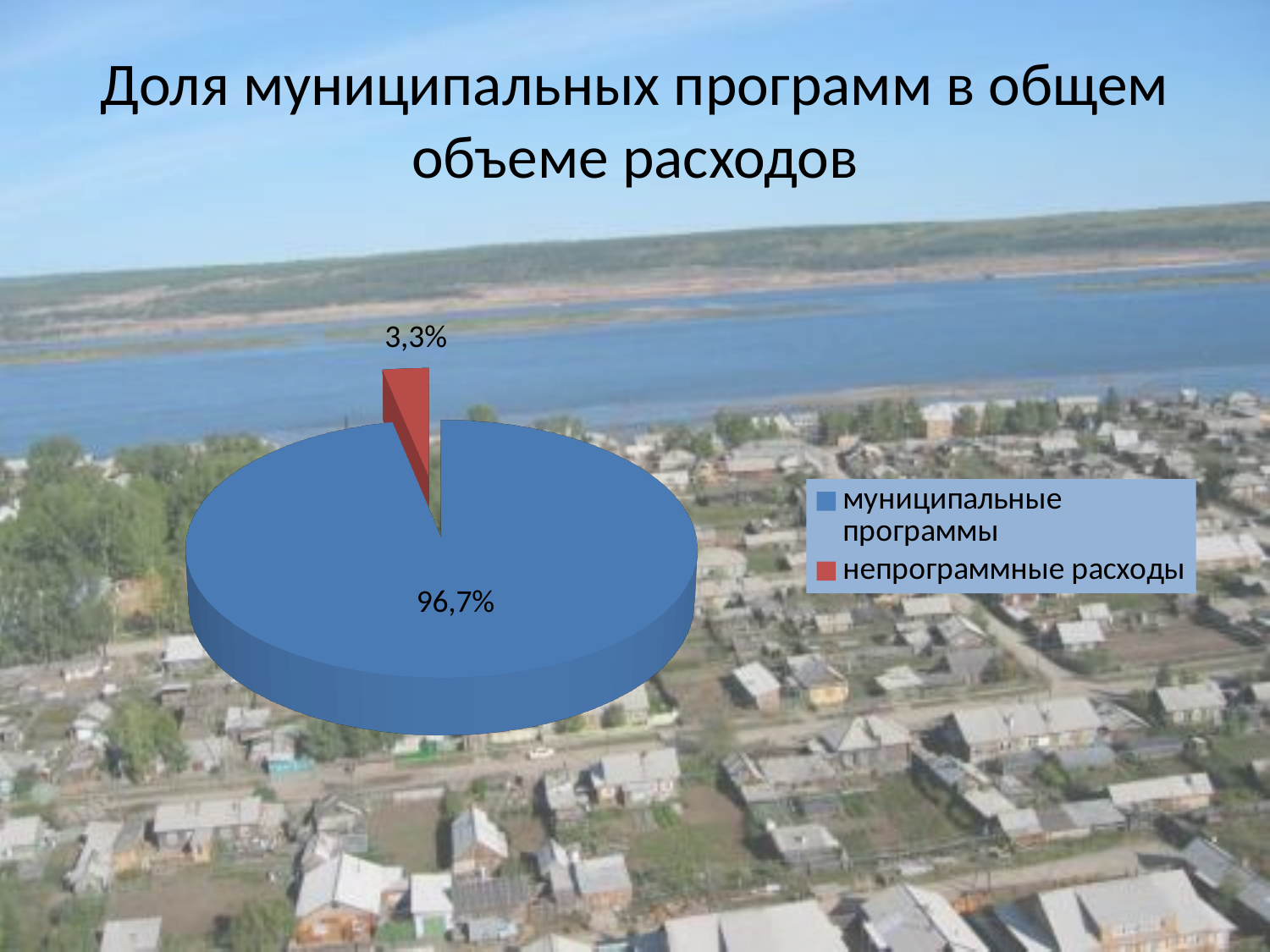
What is the title of the chart on the slide? Доля муниципальных программ в общем объеме расходов What kind of chart is shown on the slide? pie chart What colour is the slice for непрограммные расходы? red Which is larger: the share for муниципальные программы or for непрограммные расходы? муниципальные программы How many entries does the legend list? 2 How many slices does the pie chart have? 2 Which slice of the pie is the smallest? непрограммные расходы Which slice of the pie is the largest? муниципальные программы What is the difference in percentage points between the share for муниципальные программы and the share for непрограммные расходы? 93,4 What share of the pie is labelled for муниципальные программы? 96,7% What share of the pie is labelled for непрограммные расходы? 3,3%